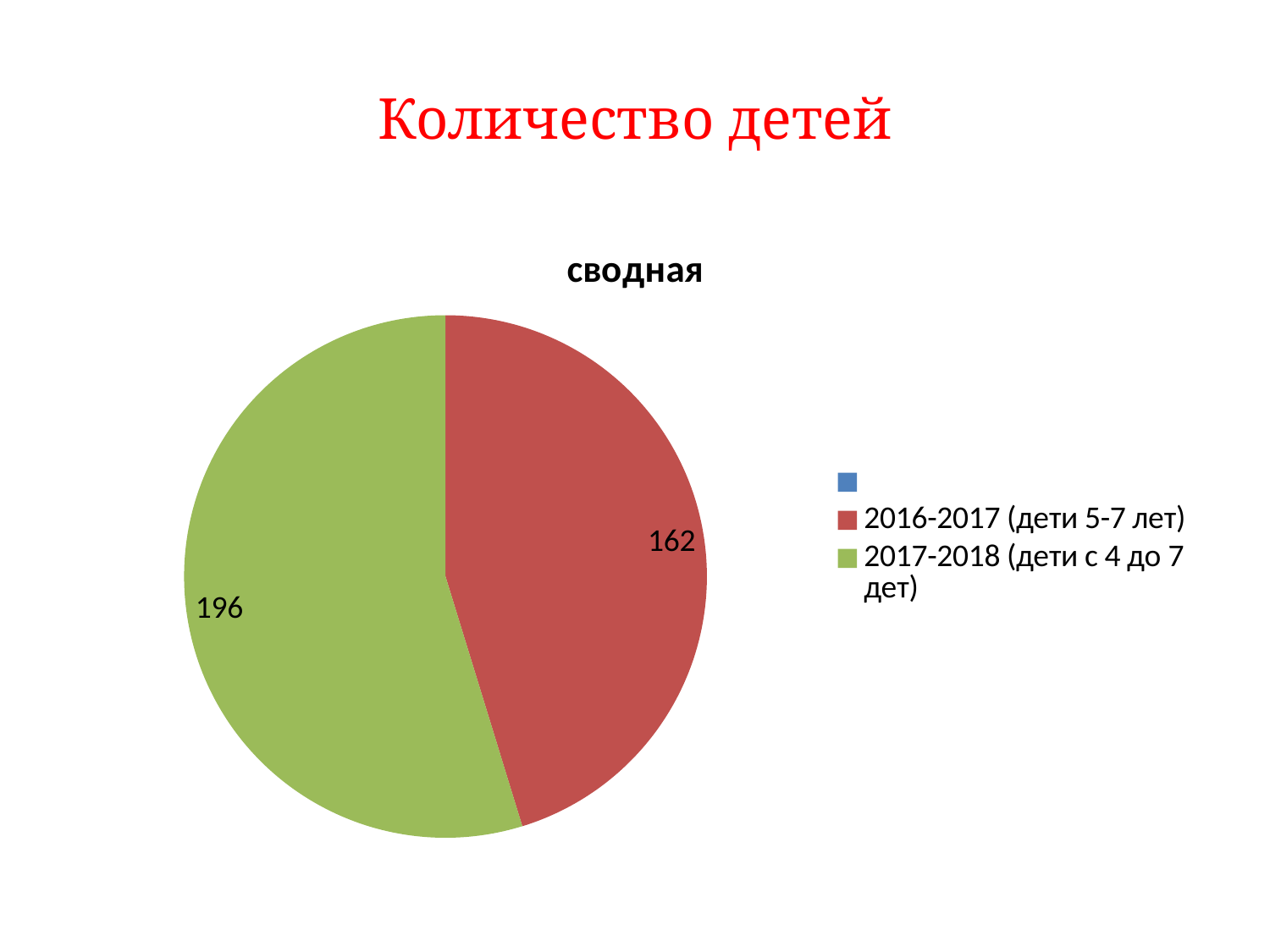
What is the value for 2016-2017 (дети 5-7 лет)? 162 How many slices does the pie chart have? 2 What colour is the slice for 2016-2017 (дети 5-7 лет)? red Which category has the largest slice of the pie? 2017-2018 (дети с 4 до 7 дет) Which is larger, the value for 2016-2017 or the value for 2017-2018? 2017-2018 What is the value for 2017-2018 (дети с 4 до 7 дет)? 196 What share of the pie does the 2017-2018 slice represent? 54.7% What is the difference between the values for 2017-2018 and 2016-2017? 34 What type of chart is shown on the slide? pie chart What is the total of the two slices in the pie chart? 358 Which category has the smallest slice of the pie? 2016-2017 (дети 5-7 лет) What is the title of the chart? сводная